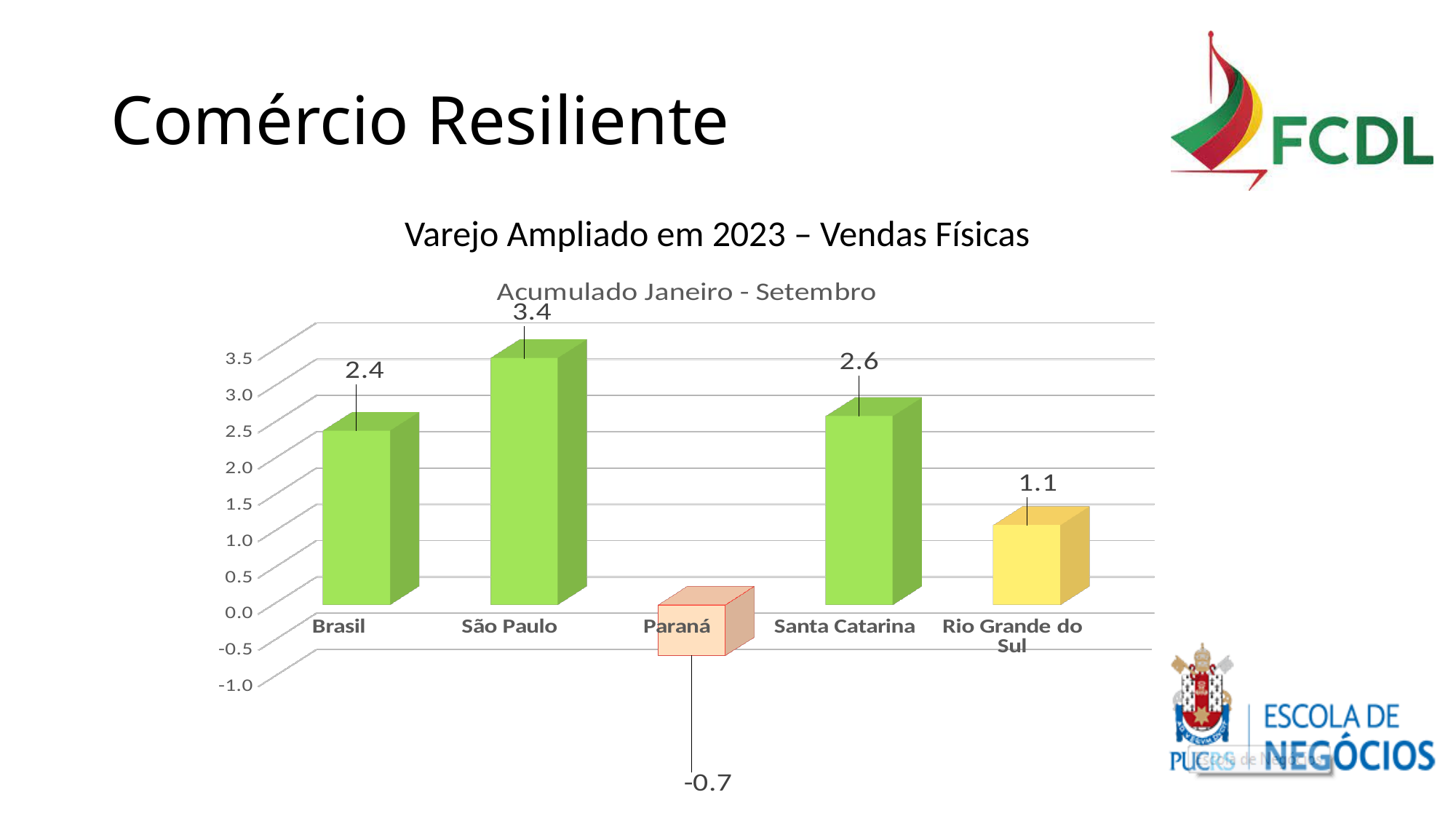
Which is larger, the value for Brasil or the value for Santa Catarina? Santa Catarina What is the value for Paraná? -0.7 How many categories are shown in the chart? 5 What is the value for Santa Catarina? 2.6 What kind of chart is shown on the slide? Bar chart What is the difference between the values for São Paulo and Rio Grande do Sul? 2.3 Which category has the highest value? São Paulo What is the value for Rio Grande do Sul? 1.1 Which category has the lowest value? Paraná What is the title of the chart? Acumulado Janeiro - Setembro What is the value for São Paulo? 3.4 What is the value for Brasil? 2.4